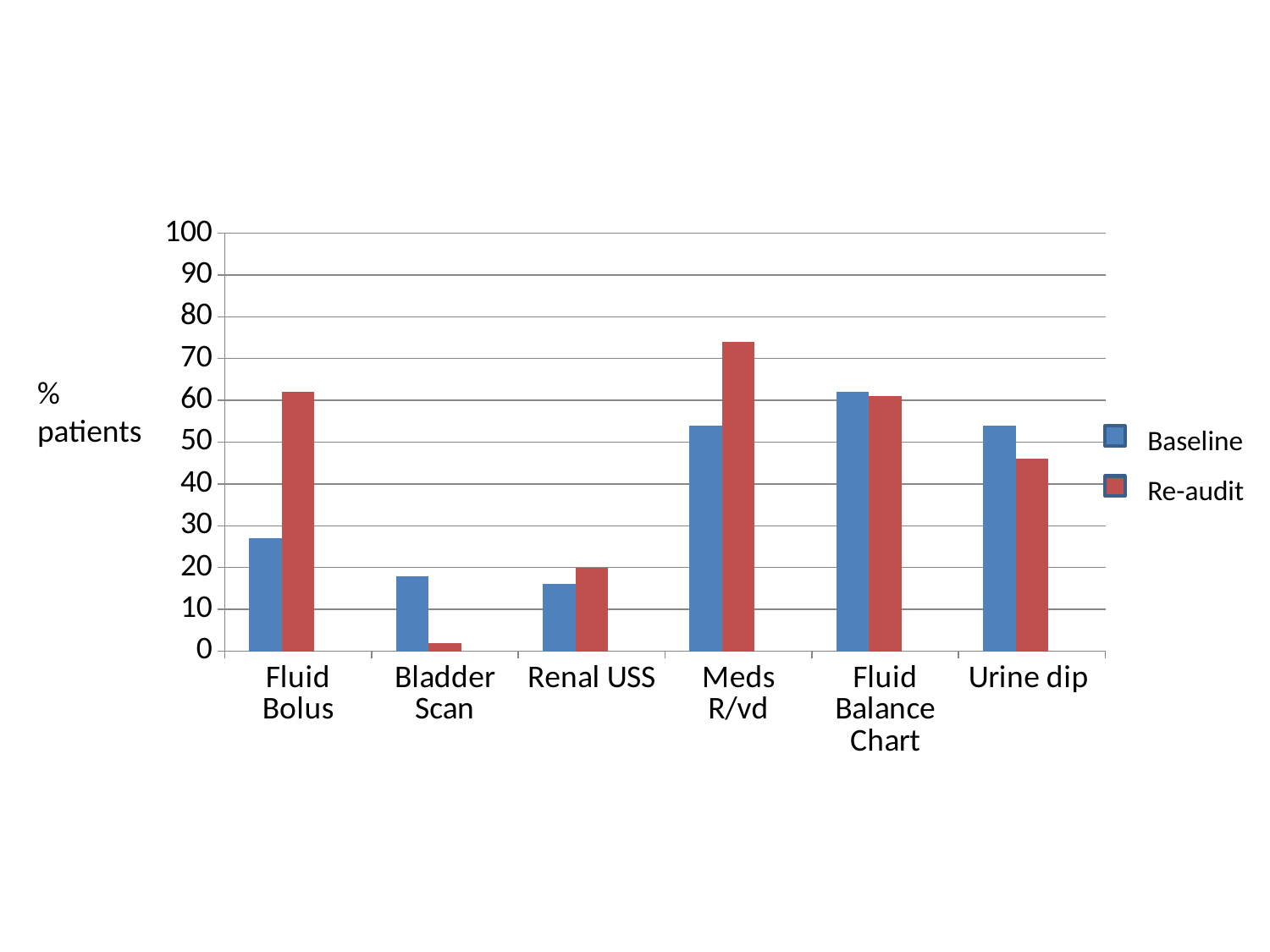
Which category has the highest Re-audit value? Meds R/vd Is the Re-audit value for Fluid Bolus greater or less than 50? greater What is the label on the y axis? % patients For Urine dip, which is larger, the Baseline value or the Re-audit value? Baseline Which category has the highest Baseline value? Fluid Balance Chart How many categories are shown on the x axis? 6 Which category has the lowest Re-audit value? Bladder Scan For Fluid Bolus, which is larger, the Baseline value or the Re-audit value? Re-audit Is the Re-audit value for Bladder Scan greater or less than 10? less What kind of chart is shown on the slide? bar chart How many series does the legend list? 2 Is the Re-audit value for Meds R/vd greater or less than 70? greater